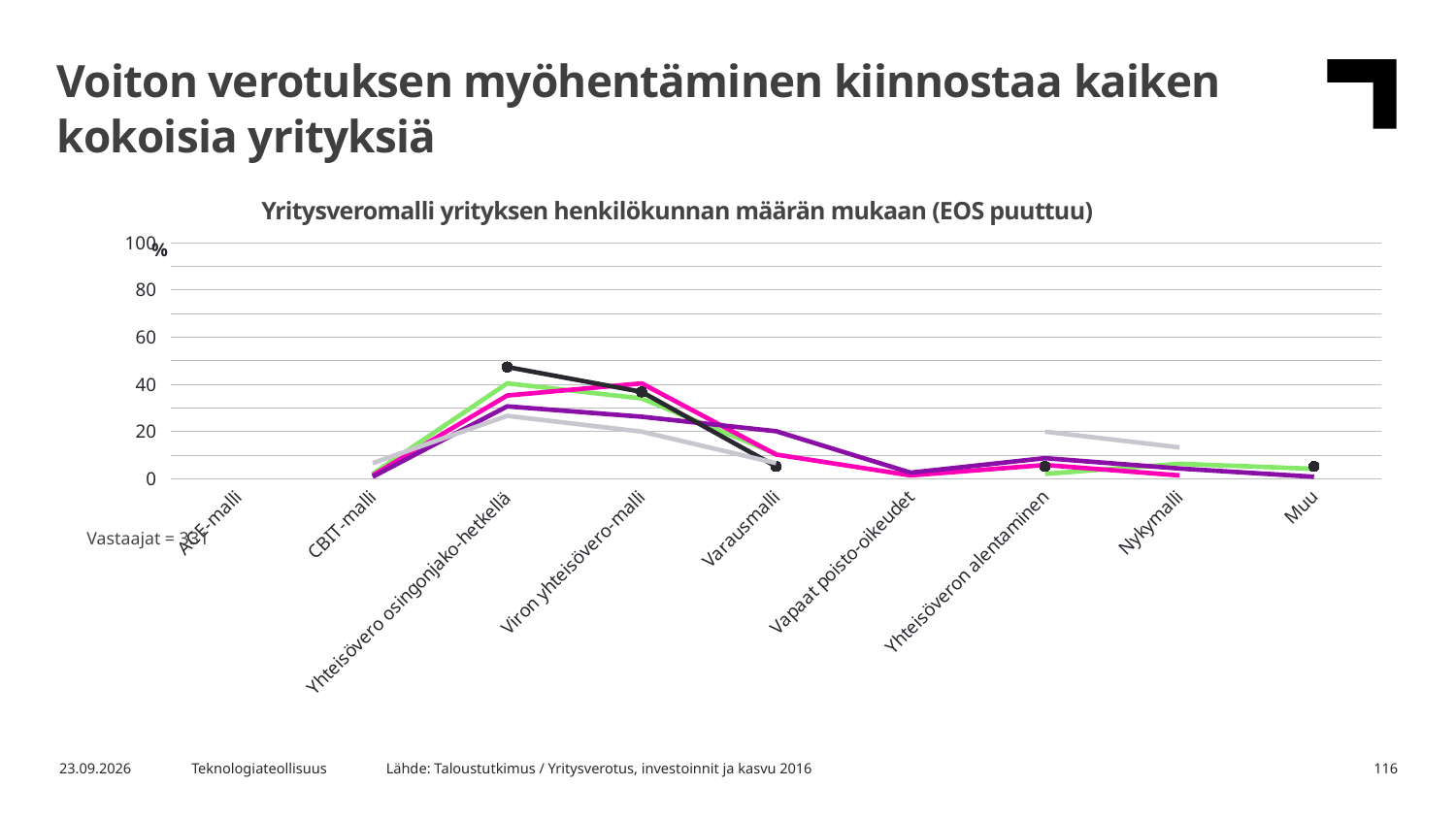
What kind of chart is shown on the slide? line chart What is the highest value shown on the y axis of the chart? 100 Is the value of the black line for Varausmalli greater or less than 20? less Is the value of the black line for Yhteisövero osingonjako-hetkellä greater or less than 40? greater Is the value of the grey line for Yhteisövero osingonjako-hetkellä greater or less than 40? less For which category does the black line reach its highest value? Yhteisövero osingonjako-hetkellä For which category does the magenta line reach its highest value? Viron yhteisövero-malli Does the black line rise or fall from Yhteisövero osingonjako-hetkellä to Varausmalli? fall How many categories are shown along the x axis of the chart? 9 For the black line, is the value larger at Yhteisövero osingonjako-hetkellä or at Varausmalli? Yhteisövero osingonjako-hetkellä What is the title of the chart? Yritysveromalli yrityksen henkilökunnan määrän mukaan (EOS puuttuu)